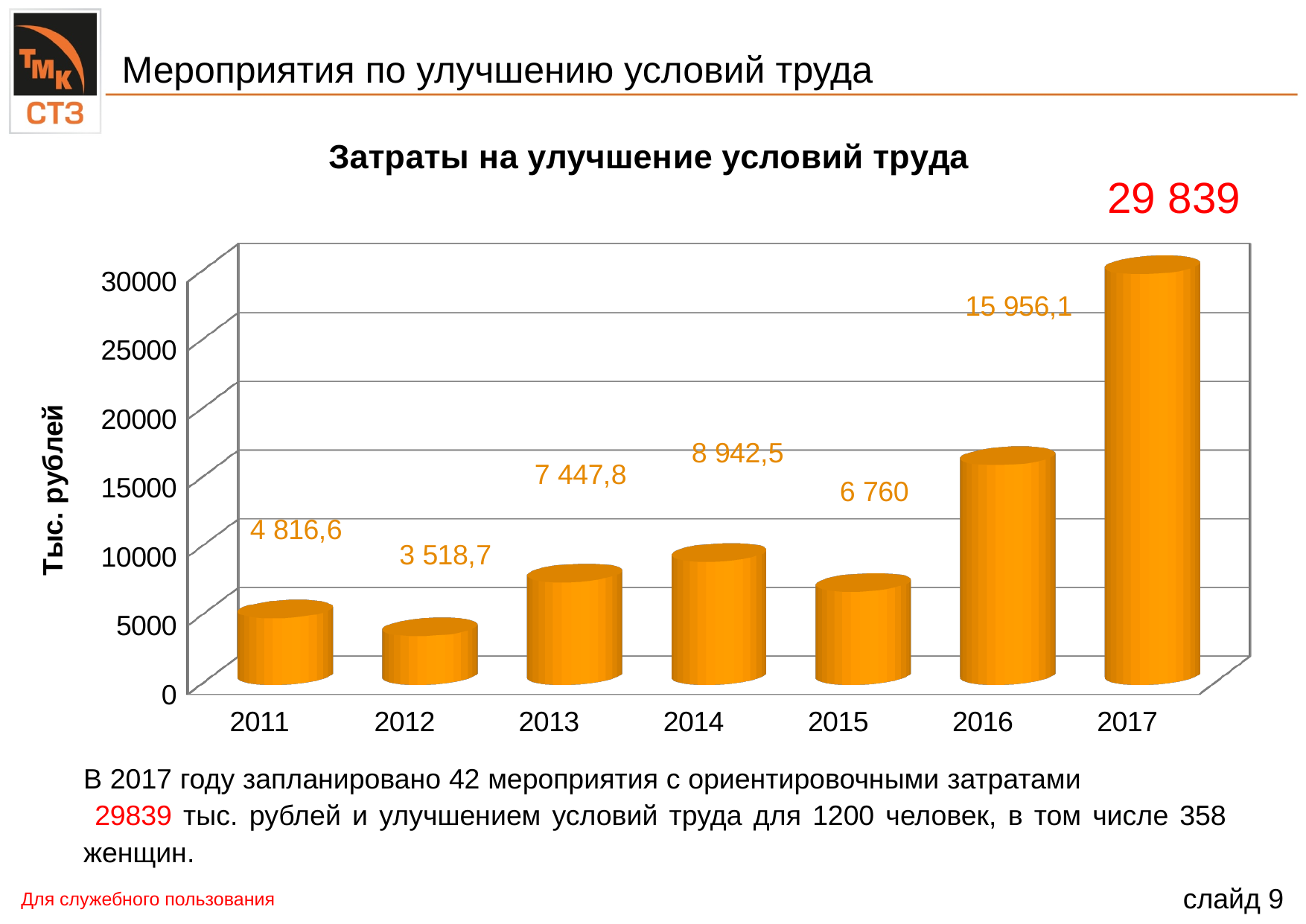
What is the label of the vertical axis of the chart? Тыс. рублей How many years are shown on the x axis of the chart? 7 Which year has the highest value in the chart? 2017 What is the value for 2016 in the chart? 15 956,1 What is the difference between the values for 2017 and 2016? 13 882,9 Which is larger, the value for 2014 or the value for 2015? 2014 What is the difference between the values for 2014 and 2013? 1 494,7 Is the value for 2016 greater or less than 15000? greater What is the value for 2013 in the chart 'Затраты на улучшение условий труда'? 7 447,8 Which year has the lowest value in the chart? 2012 What kind of chart is shown on the slide? bar chart What is the value for 2015 in the chart? 6 760